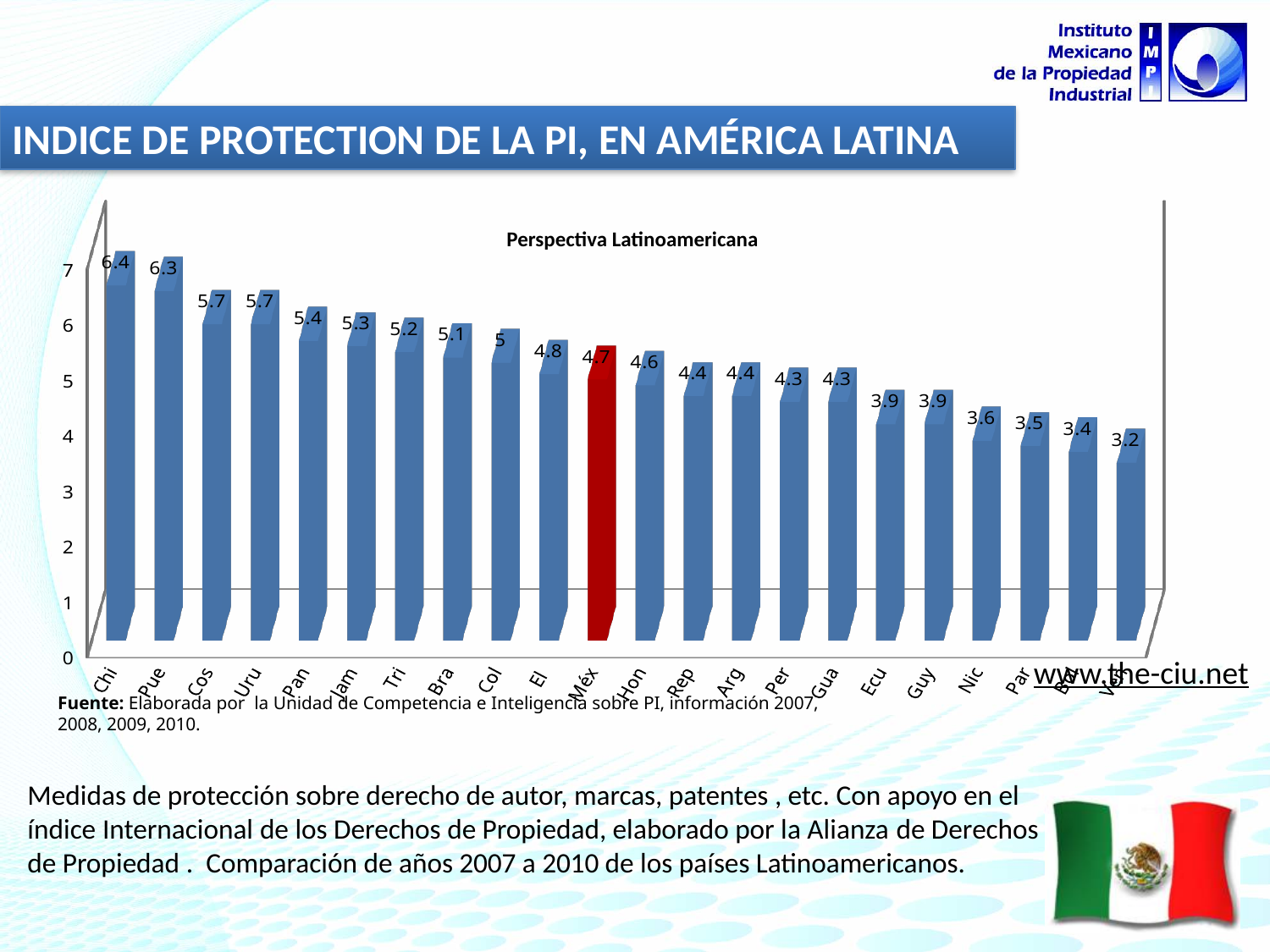
What is the difference between the values for Chi and Méx? 1.7 Is the value for Nic greater or less than 4? less What kind of chart is shown on the slide? bar chart What is the title printed inside the chart area? Perspectiva Latinoamericana How many bars are plotted in the chart? 22 What is the value for Bra? 5.1 What is the value for Méx, the red bar? 4.7 What is the value for Ecu? 3.9 Which is larger, the value for Pan or the value for Per? Pan Which category has the highest value? Chi What is the difference between the values for Pue and Hon? 1.7 What is the value for Chi? 6.4